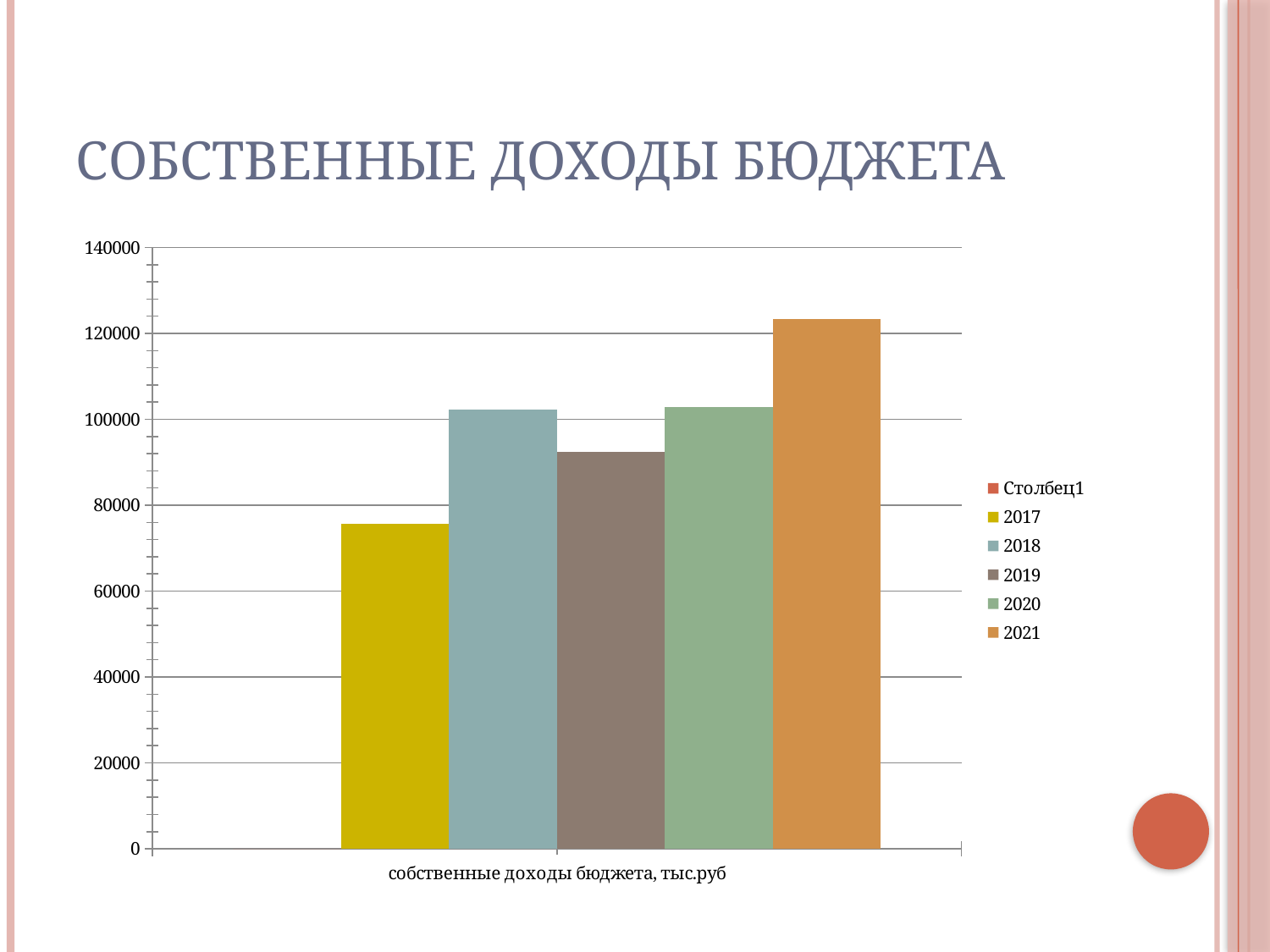
Is the value for 2019 greater or less than 100000? less Which year has the tallest bar? 2021 Is the value for 2019 greater or less than 80000? greater What is the title of the slide above the chart? СОБСТВЕННЫЕ ДОХОДЫ БЮДЖЕТА What kind of chart is shown on the slide? bar chart Is the value for 2021 greater or less than 120000? greater Which is larger, the value for 2021 or the value for 2018? 2021 How many entries does the legend list? 6 What is the label shown under the bars on the horizontal axis? собственные доходы бюджета, тыс.руб Which year has the shortest bar among the plotted bars? 2017 Which is larger, the value for 2019 or the value for 2017? 2019